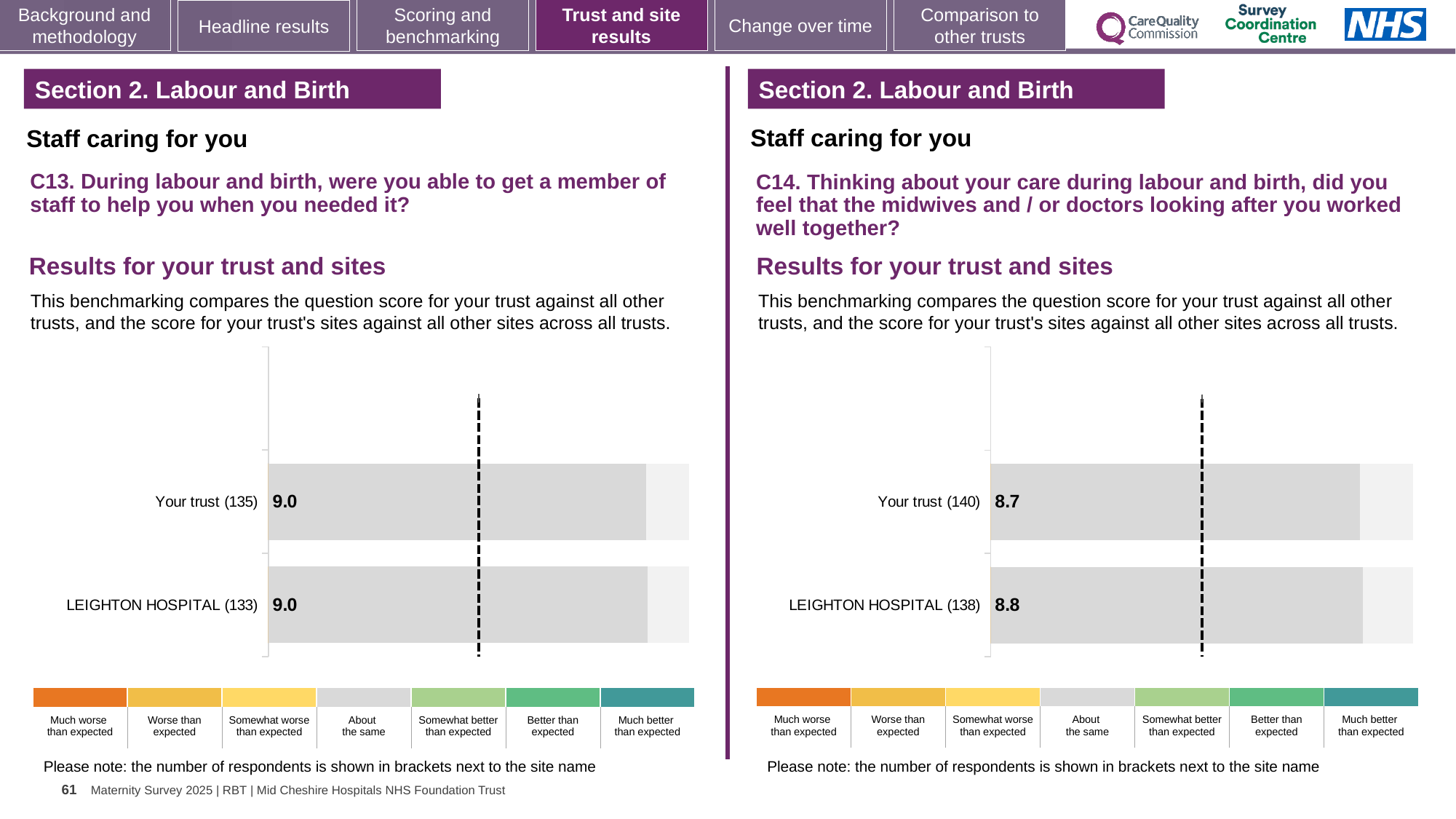
In the C14 chart on the right, what is the score for Your trust? 8.7 How many categories does the colour key below the C13 chart on the left list? 7 In the C14 chart on the right, how many respondents are shown in brackets for Your trust? 140 In the C13 chart on the left, what is the score for Your trust? 9.0 In the C14 chart on the right, what is the score for LEIGHTON HOSPITAL? 8.8 How many bars are plotted in the C14 chart on the right? 2 In the C13 chart on the left, what is the score for LEIGHTON HOSPITAL? 9.0 What type of chart is used for the C14 results on the right? Bar chart In the C14 chart on the right, which has the higher score, Your trust or LEIGHTON HOSPITAL? LEIGHTON HOSPITAL In the C13 chart on the left, what is the difference between the Your trust score and the LEIGHTON HOSPITAL score? 0.0 In the C14 chart on the right, what is the difference between the LEIGHTON HOSPITAL score and the Your trust score? 0.1 How many bars are plotted in the C13 chart on the left? 2